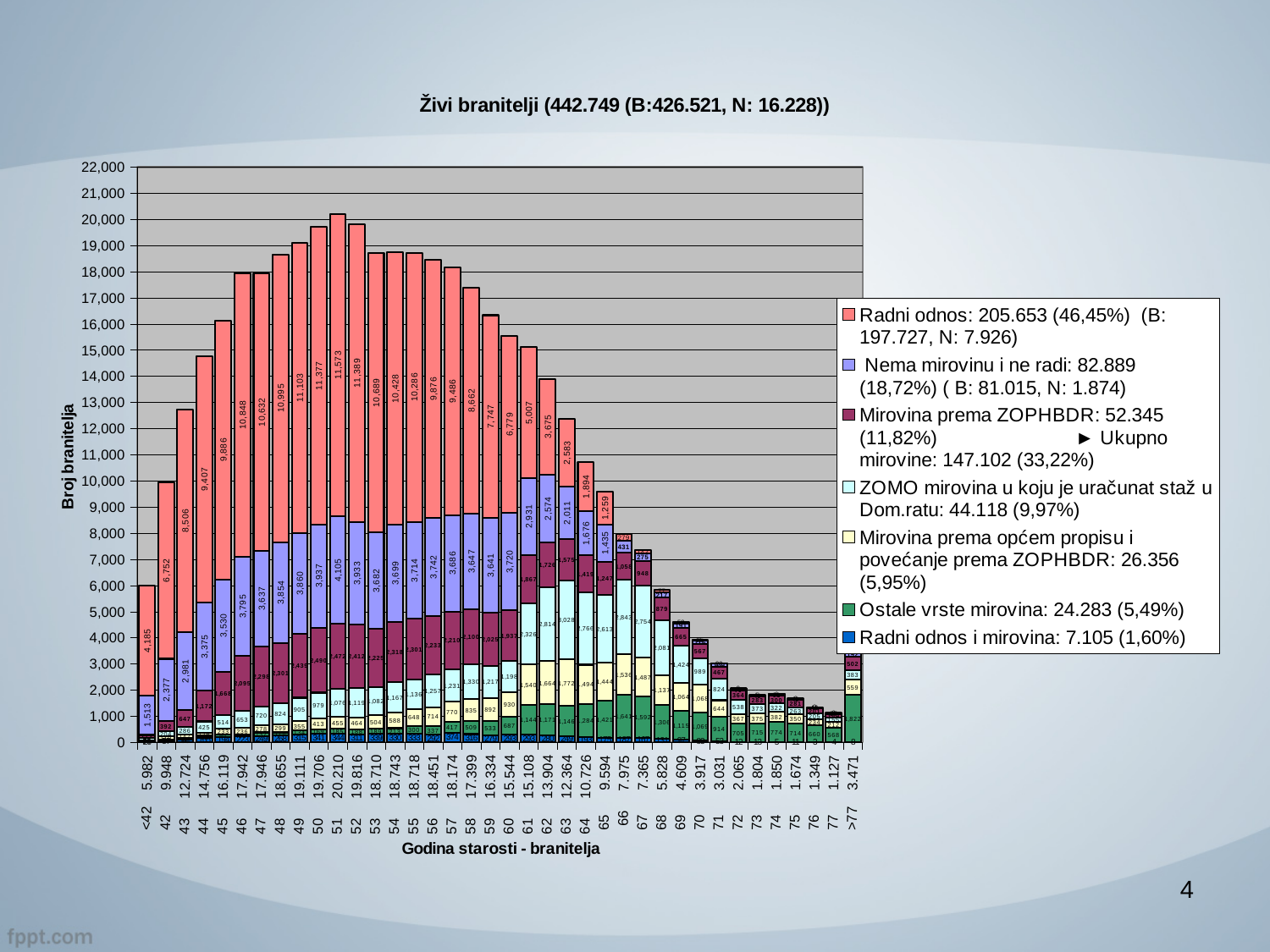
What is the difference between the Radni odnos values for age 51 and age 52? 184 How many series does the legend list? 7 Which age category has the tallest total bar? 51 Which has the larger Radni odnos value, age 46 or age 47? age 46 What is the title of the y axis? Broj branitelja What is the value of the Nema mirovinu i ne radi segment for age 50? 3,937 How many age categories are shown on the x axis? 38 Is the total bar for age 60 greater or less than 15,000? greater What is the value of the Radni odnos segment for age 65? 1,259 What is the value of the Radni odnos segment for age 51? 11,573 According to the legend, what percentage share does Radni odnos have? 46,45% What kind of chart is shown on the slide? stacked bar chart